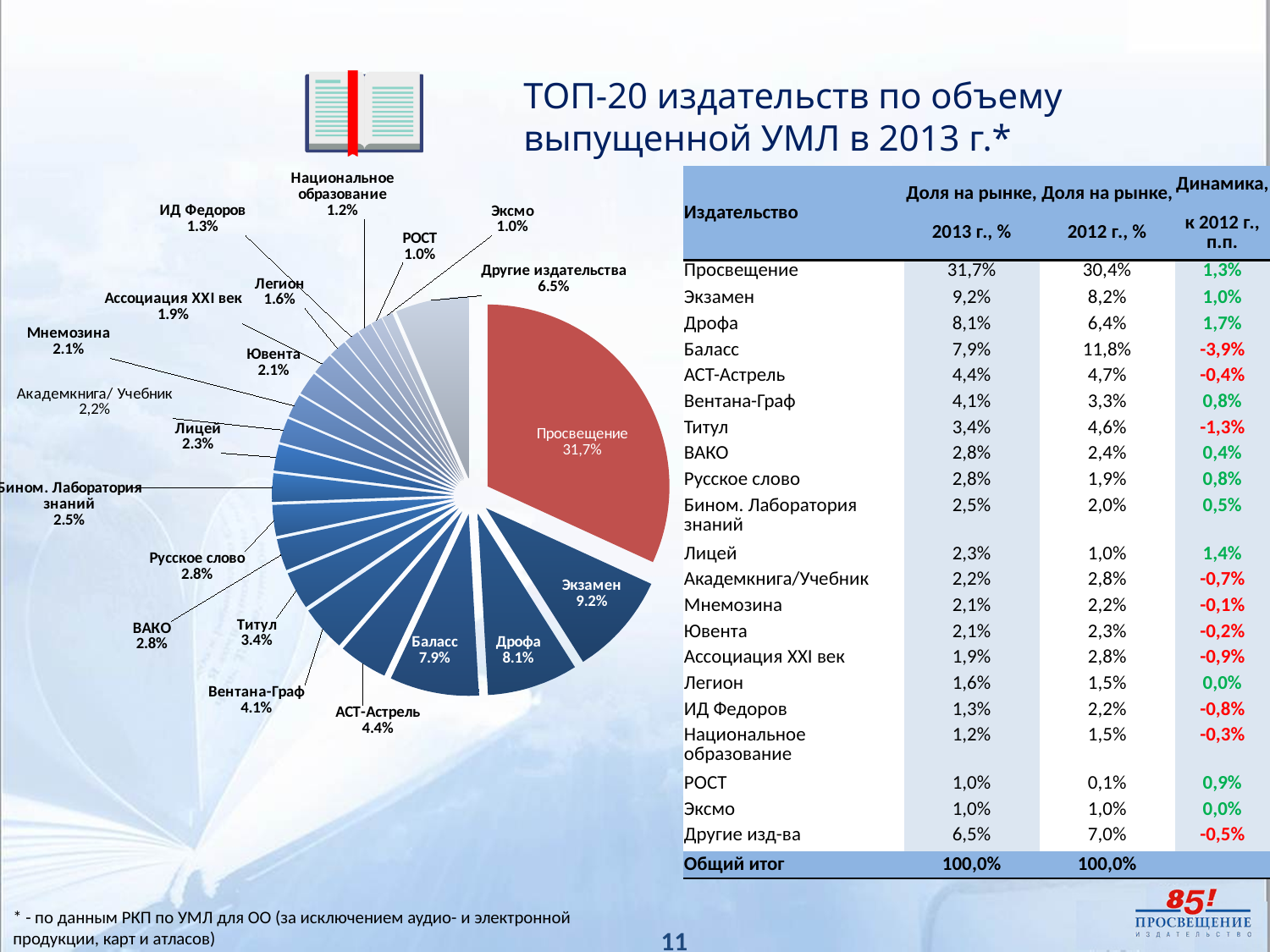
What is the difference between the values for Экзамен and Дрофа in the pie chart? 1.1% Which is larger in the pie chart, Дрофа or Баласс? Дрофа What is the value shown for Вентана-Граф in the pie chart? 4.1% Which is larger in the pie chart, Титул or АСТ-Астрель? АСТ-Астрель What is the value shown for Другие издательства in the pie chart? 6.5% What is the value shown for Баласс in the pie chart? 7.9% How many slices does the pie chart have? 21 What kind of chart is shown on the slide? pie chart Which publisher has the largest slice of the pie chart? Просвещение What share of the pie does Просвещение hold? 31,7% What is the value shown for Экзамен in the pie chart? 9.2% What colour is the Просвещение slice in the pie chart? red